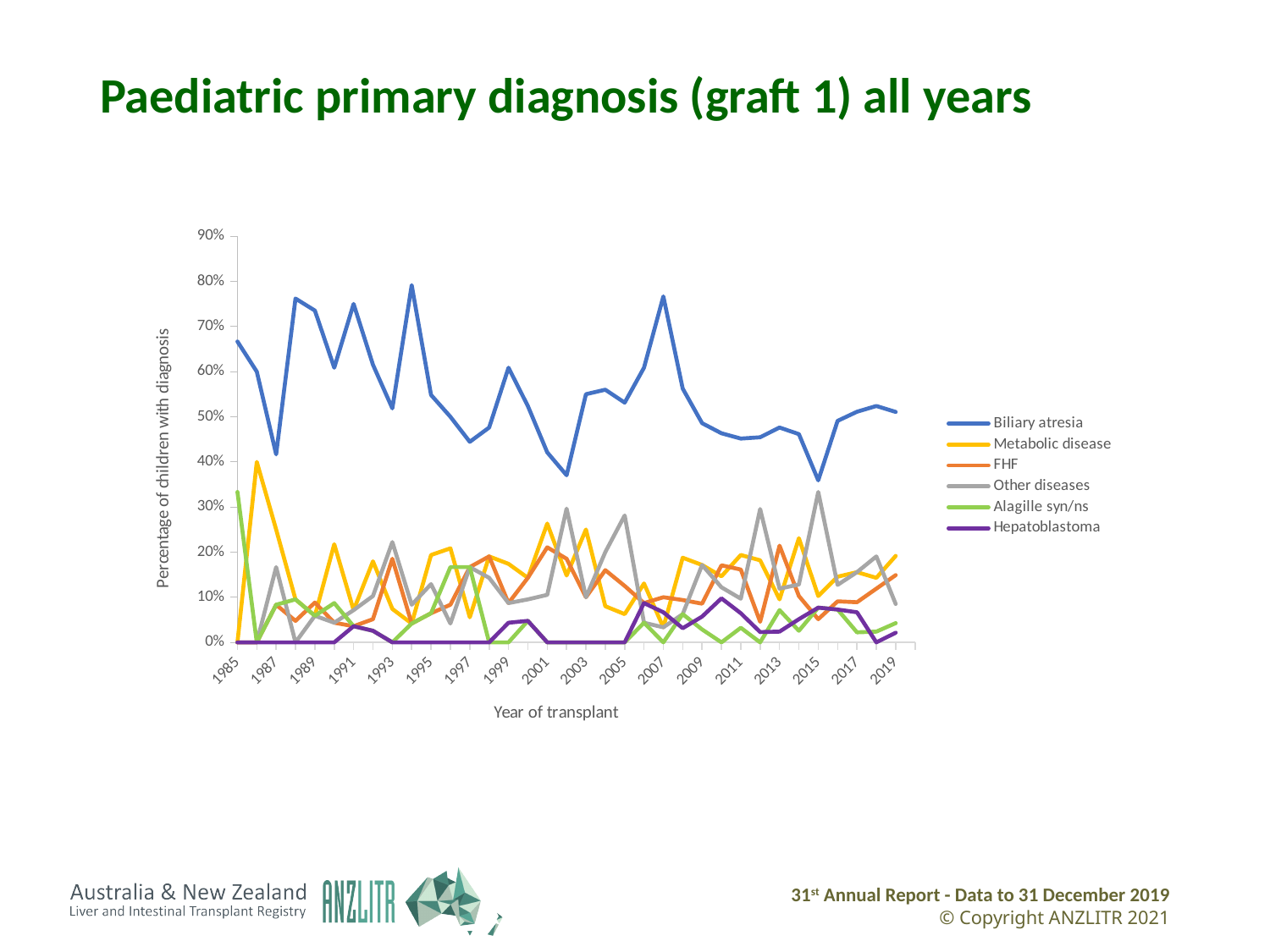
Which series has the highest values across the chart? Biliary atresia Which is larger in 1994, the value for Biliary atresia or the value for Metabolic disease? Biliary atresia What is the value for Hepatoblastoma in 1985? 0% Does the value for Biliary atresia rise or fall between 2007 and 2015? Fall Is the value for Biliary atresia in 1994 greater or less than 70%? greater How many series does the legend list? 6 What is the label of the y axis? Percentage of children with diagnosis What kind of chart is shown on the slide? Line chart What is the title of the chart? Paediatric primary diagnosis (graft 1) all years Is the value for Biliary atresia in 2015 greater or less than 40%? less Is the value for Biliary atresia in 2007 greater or less than 70%? greater